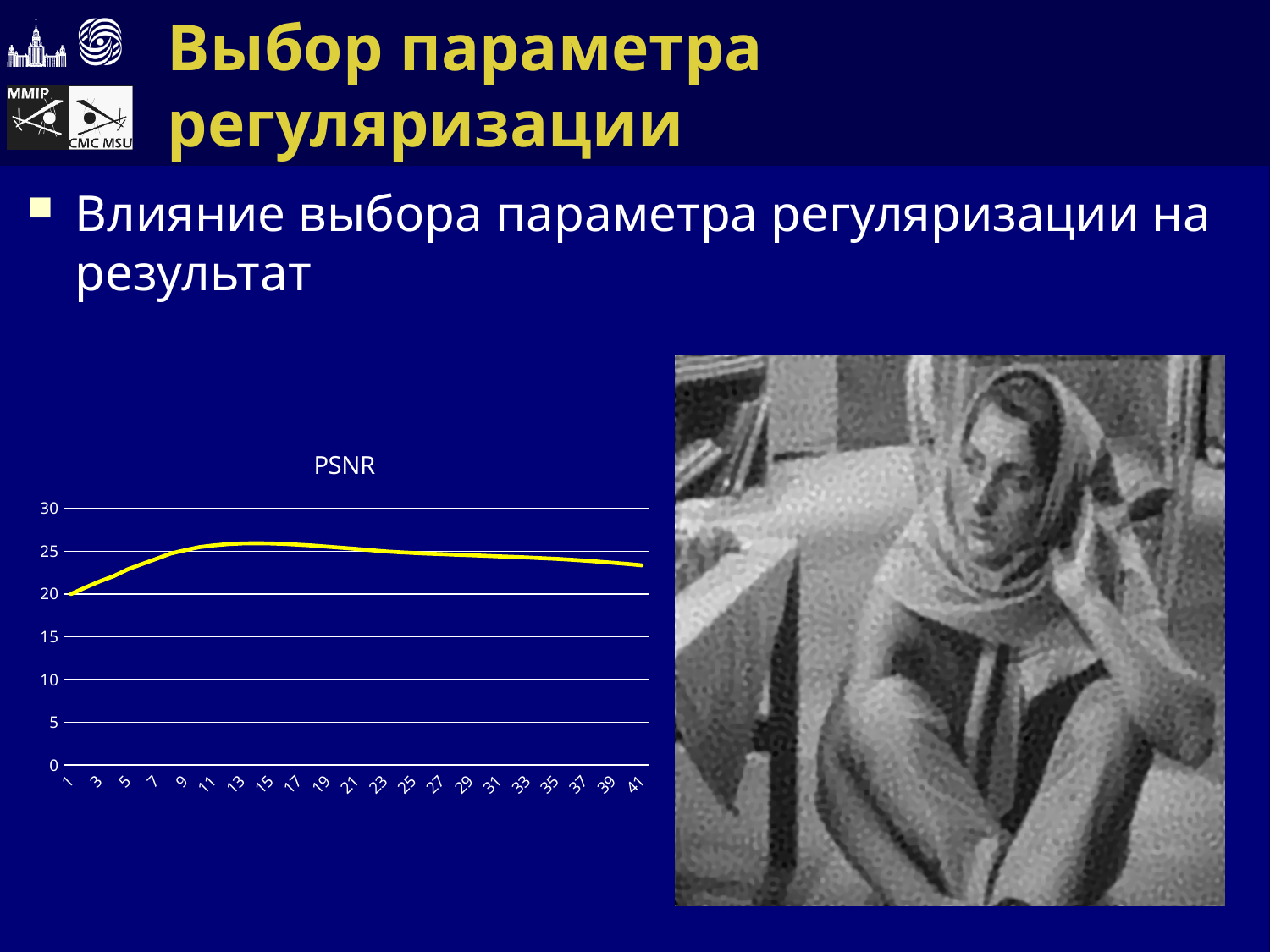
Is the PSNR value at x = 1 greater or less than 25? less Is the PSNR value at x = 41 greater or less than 25? less What is the highest tick value shown on the y axis of the PSNR chart? 30 Which has the larger PSNR value, x = 1 or x = 13? 13 Which has the larger PSNR value, x = 1 or x = 41? 41 How does the PSNR line behave along the x axis? rises, then falls Is the PSNR value at x = 41 greater or less than 20? greater What is the title of the chart? PSNR What kind of chart is shown on the slide? line chart Which has the larger PSNR value, x = 13 or x = 41? 13